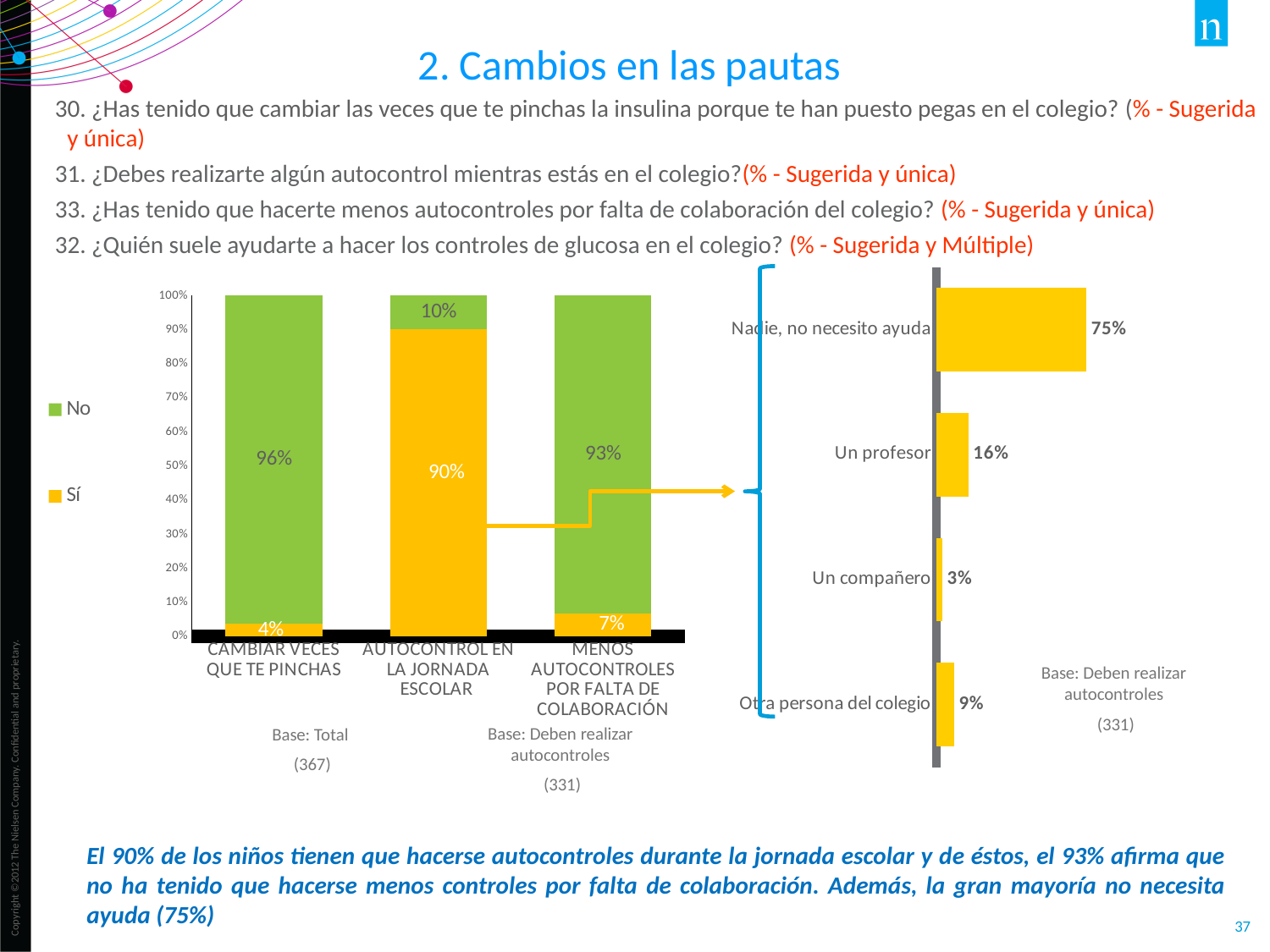
In the stacked bar chart on the left, how many categories are shown on the x axis? 3 In the stacked bar chart on the left, what is the difference between the 'No' values for 'CAMBIAR VECES QUE TE PINCHAS' and 'MENOS AUTOCONTROLES POR FALTA DE COLABORACIÓN'? 3% In the horizontal bar chart on the right, which is larger: 'Un profesor' or 'Otra persona del colegio'? Un profesor In the stacked bar chart on the left, which category has the lowest 'No' value? AUTOCONTROL EN LA JORNADA ESCOLAR In the horizontal bar chart on the right, what is the difference between 'Un profesor' and 'Un compañero'? 13% In the horizontal bar chart on the right, which category has the lowest value? Un compañero In the stacked bar chart on the left, what is the 'Sí' value for 'MENOS AUTOCONTROLES POR FALTA DE COLABORACIÓN'? 7% In the horizontal bar chart on the right, what is the value for 'Nadie, no necesito ayuda'? 75% In the stacked bar chart on the left, what is the 'Sí' value for 'AUTOCONTROL EN LA JORNADA ESCOLAR'? 90% In the stacked bar chart on the left, how many series does the legend list? 2 In the stacked bar chart on the left, what is the 'No' value for 'CAMBIAR VECES QUE TE PINCHAS'? 96% In the stacked bar chart on the left, which category has the highest 'Sí' value? AUTOCONTROL EN LA JORNADA ESCOLAR